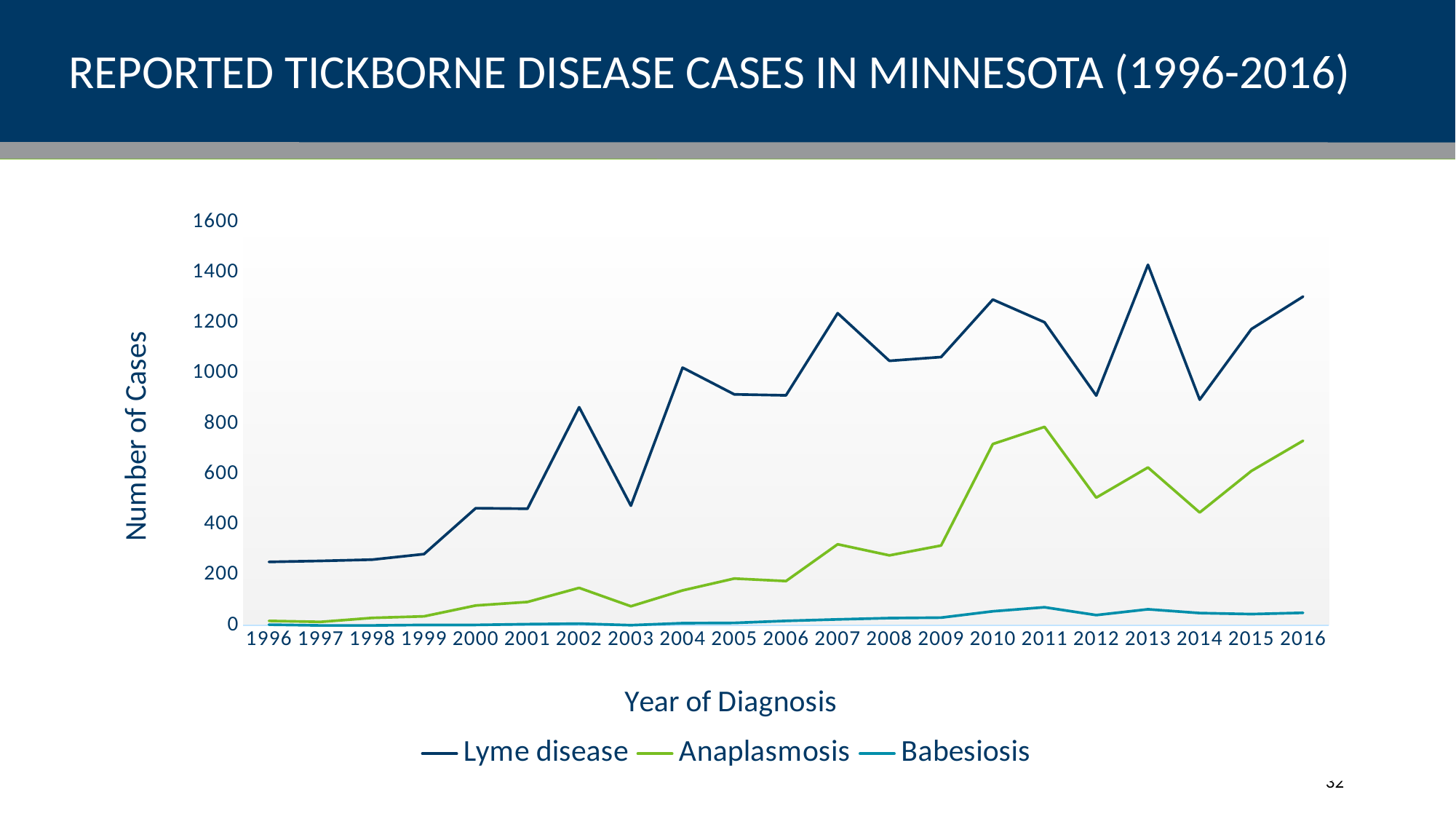
Is the value for Anaplasmosis in 2011 greater or less than 600? greater What kind of chart is shown on the slide? Line chart In which year does the Anaplasmosis line reach its highest value? 2011 How many years are plotted along the x axis? 21 Is the value for Lyme disease in 2013 greater or less than 1200? greater In which year does the Lyme disease line reach its highest value? 2013 How many series does the legend list? 3 Is the value for Lyme disease in 1996 greater or less than 400? less Overall, does the Lyme disease line rise or fall from 1996 to 2016? Rise What is the title of the y axis? Number of Cases Which is larger, the Lyme disease value in 2002 or in 2003? 2002